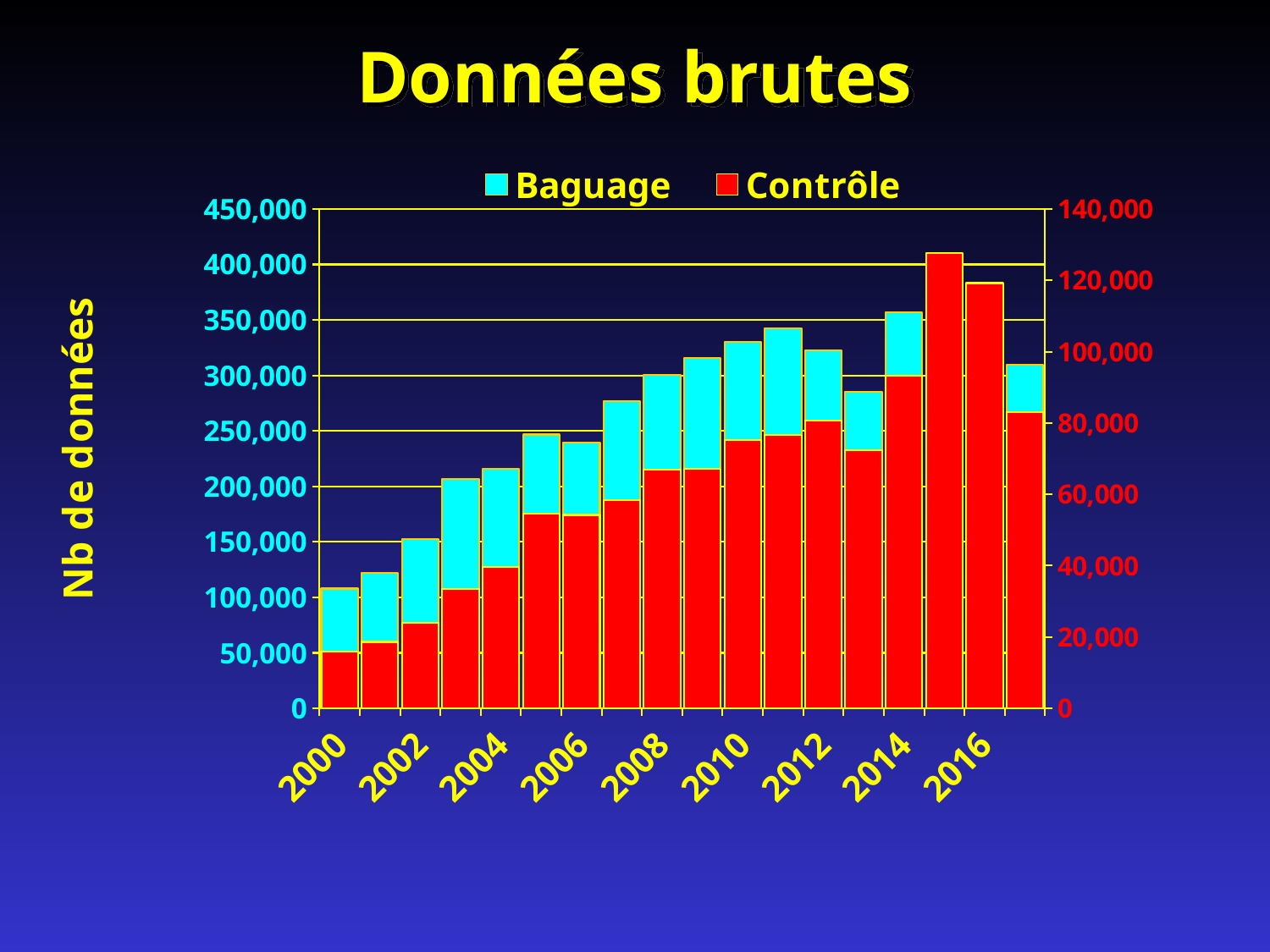
What kind of chart is shown on the slide? bar chart What is the title of the left vertical axis? Nb de données In which year is the Contrôle value highest? 2015 What are the two series named in the legend? Baguage and Contrôle How many years (bars) are plotted along the x axis? 18 How many series does the legend list? 2 Is the Baguage value for 2000 greater or less than 150,000 on the left axis? less Which year has the larger Contrôle value, 2015 or 2016? 2015 In which year is the Contrôle value lowest? 2000 Is the Contrôle value for 2016 greater or less than 100,000 on the right axis? greater In which year is the Baguage value lowest? 2000 Is the Baguage value for 2010 greater or less than 300,000 on the left axis? greater